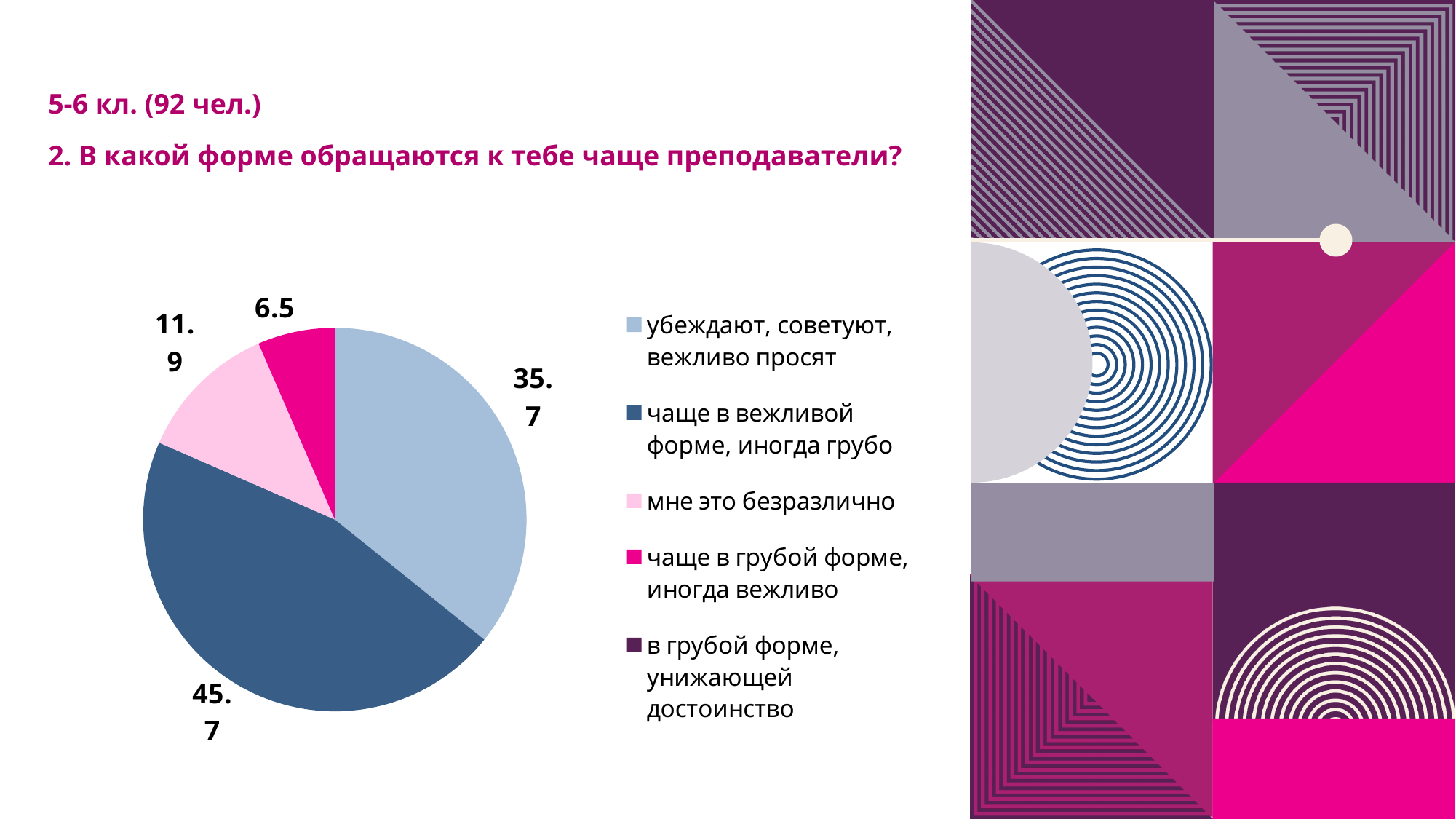
What value is shown for the slice "убеждают, советуют, вежливо просят"? 35.7 What colour is the slice for "мне это безразлично"? light pink Which category has the largest slice of the pie? чаще в вежливой форме, иногда грубо What value is shown for the slice "мне это безразлично"? 11.9 What value is shown for the slice "чаще в грубой форме, иногда вежливо"? 6.5 How many entries does the legend list? 5 How many slices with data labels are visible in the pie? 4 What value is shown for the slice "чаще в вежливой форме, иногда грубо"? 45.7 Which labelled slice of the pie is the smallest? чаще в грубой форме, иногда вежливо What is the difference between the values for "чаще в вежливой форме, иногда грубо" and "убеждают, советуют, вежливо просят"? 10 Which is larger: the value for "мне это безразлично" or the value for "чаще в грубой форме, иногда вежливо"? мне это безразлично What kind of chart is shown on the slide? pie chart